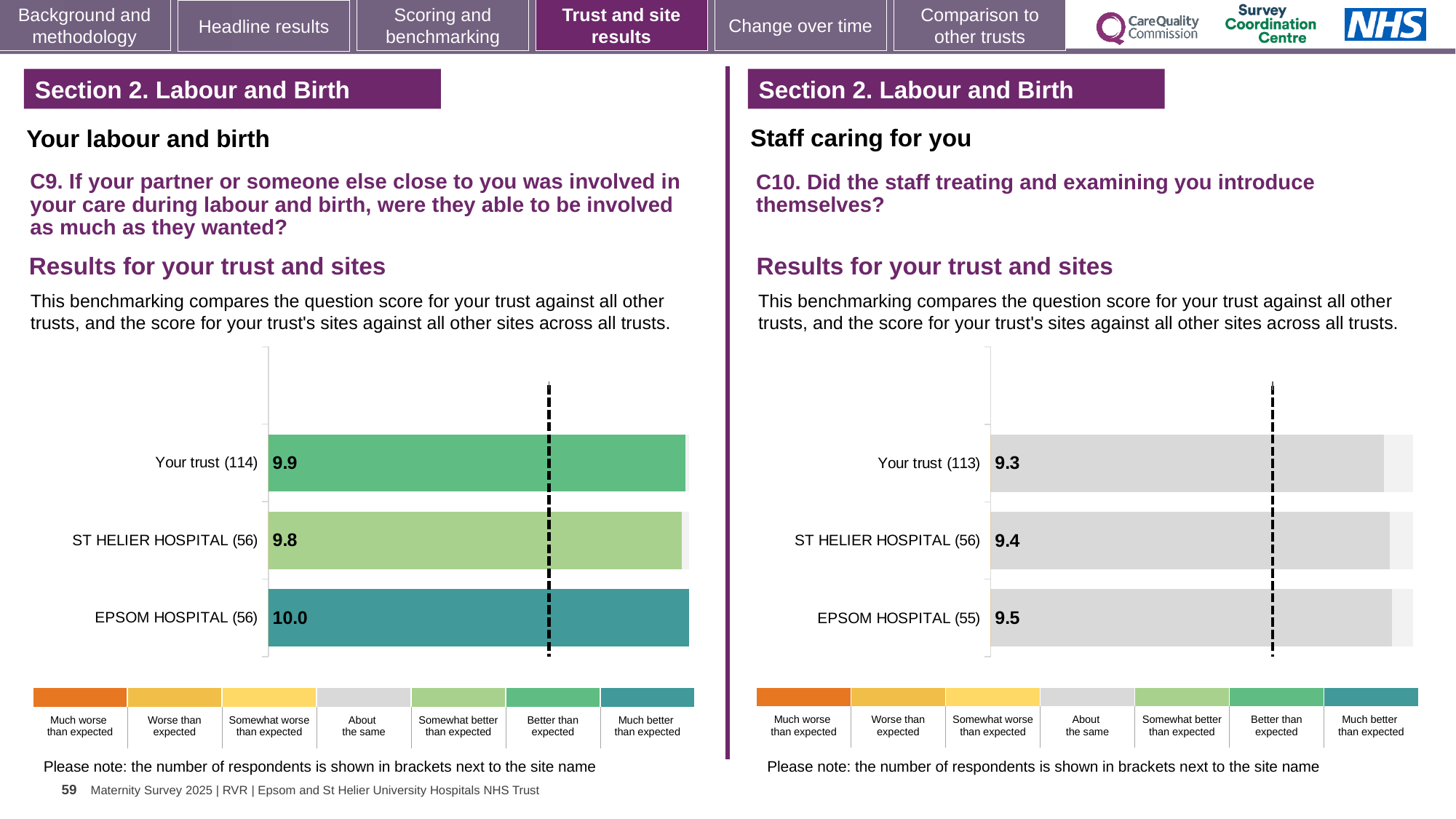
On the C10 chart (right), what is the difference between the scores for EPSOM HOSPITAL and Your trust? 0.2 On the C10 chart (right), what is the score for Your trust? 9.3 On the C10 chart (right), which site or trust has the highest score? EPSOM HOSPITAL What kind of chart is used on the C10 chart (right)? Bar chart On the C9 chart (left), which site or trust has the lowest score? ST HELIER HOSPITAL How many bars are plotted on the C9 chart (left)? 3 On the C9 chart (left), what is the score for EPSOM HOSPITAL? 10.0 On the C10 chart (right), how many respondents are shown in brackets for EPSOM HOSPITAL? 55 On the C10 chart (right), what is the score for ST HELIER HOSPITAL? 9.4 On the C9 chart (left), what is the difference between the scores for EPSOM HOSPITAL and ST HELIER HOSPITAL? 0.2 On the C9 chart (left), what is the score for Your trust? 9.9 On the C10 chart (right), which has the larger score, Your trust or EPSOM HOSPITAL? EPSOM HOSPITAL